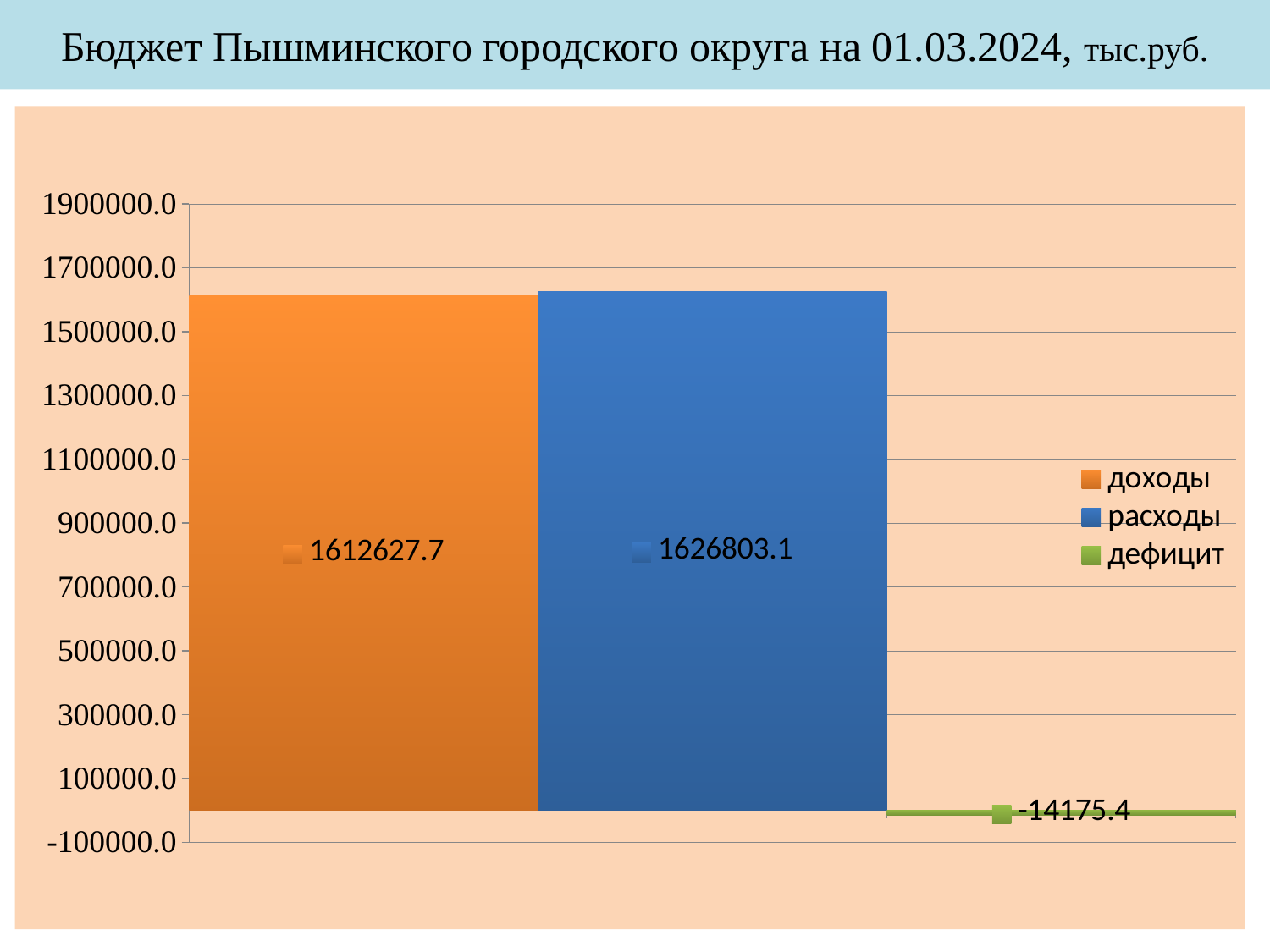
Which series has the highest value? расходы What is the value for доходы? 1612627.7 What is the value for дефицит? -14175.4 Is the value for дефицит greater or less than 100000.0? less Which series has the lowest value? дефицит How many series does the legend list? 3 What is the title of the slide? Бюджет Пышминского городского округа на 01.03.2024, тыс.руб. What is the difference between расходы and доходы? 14175.4 What is the value for расходы? 1626803.1 What kind of chart is shown on the slide? bar chart Is the value for доходы greater or less than 1500000.0? greater Which is larger, доходы or расходы? расходы